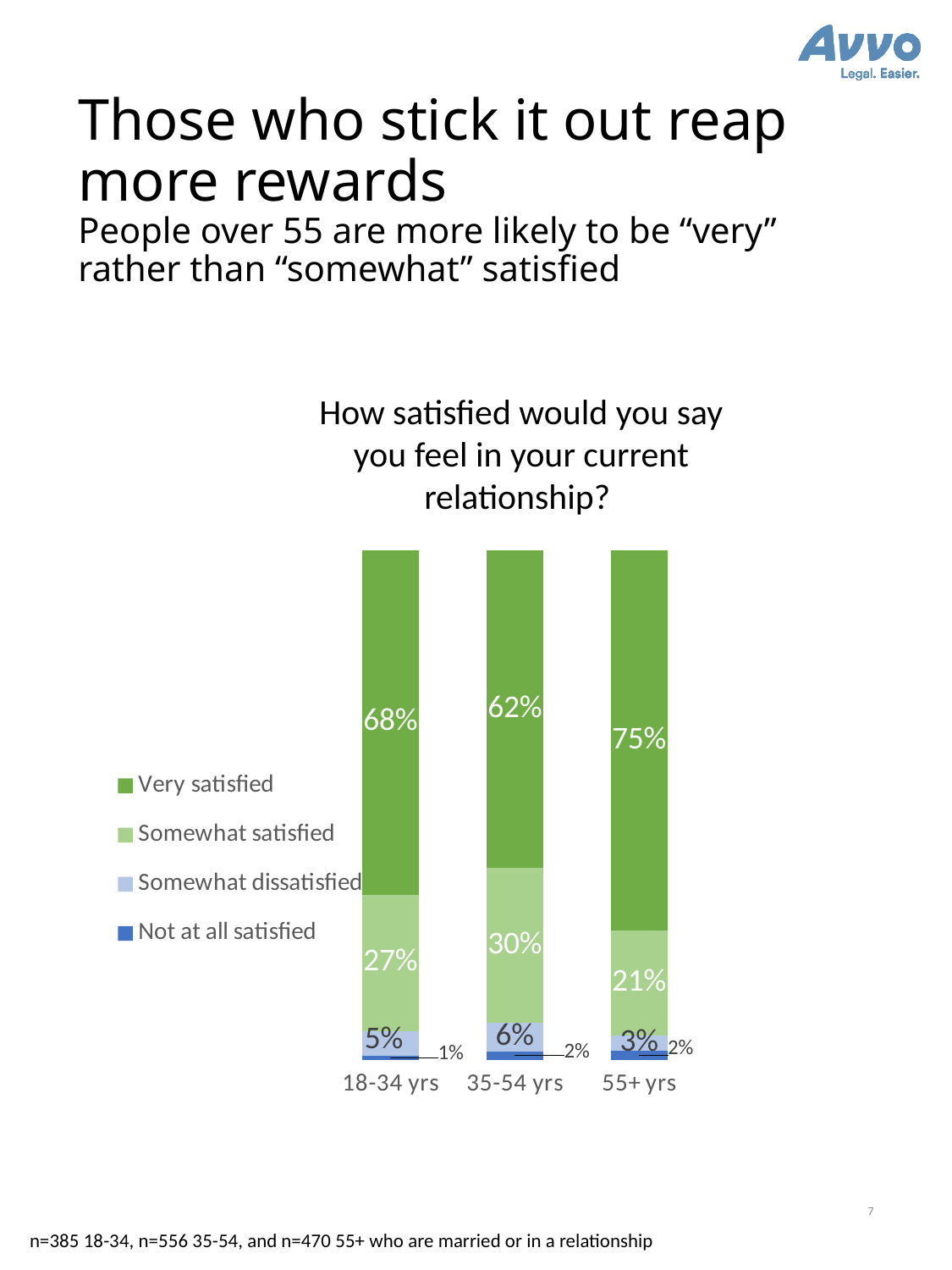
What is the 'Not at all satisfied' value for the 18-34 yrs group? 1% What is the 'Somewhat dissatisfied' value for the 18-34 yrs group? 5% What is the title of the chart? How satisfied would you say you feel in your current relationship? Which age group has the lowest 'Somewhat satisfied' percentage? 55+ yrs What percentage of people aged 55+ yrs are very satisfied in their current relationship? 75% What is the 'Somewhat satisfied' value for the 35-54 yrs group? 30% What is the difference between the 'Very satisfied' values for the 55+ yrs and 35-54 yrs groups? 13% How many series does the chart legend list? 4 Which is larger: the 'Somewhat dissatisfied' value for 35-54 yrs or for 55+ yrs? 35-54 yrs How many age groups are shown on the x axis of the chart? 3 What kind of chart is shown on the slide? Stacked bar chart Which age group has the highest 'Very satisfied' percentage? 55+ yrs